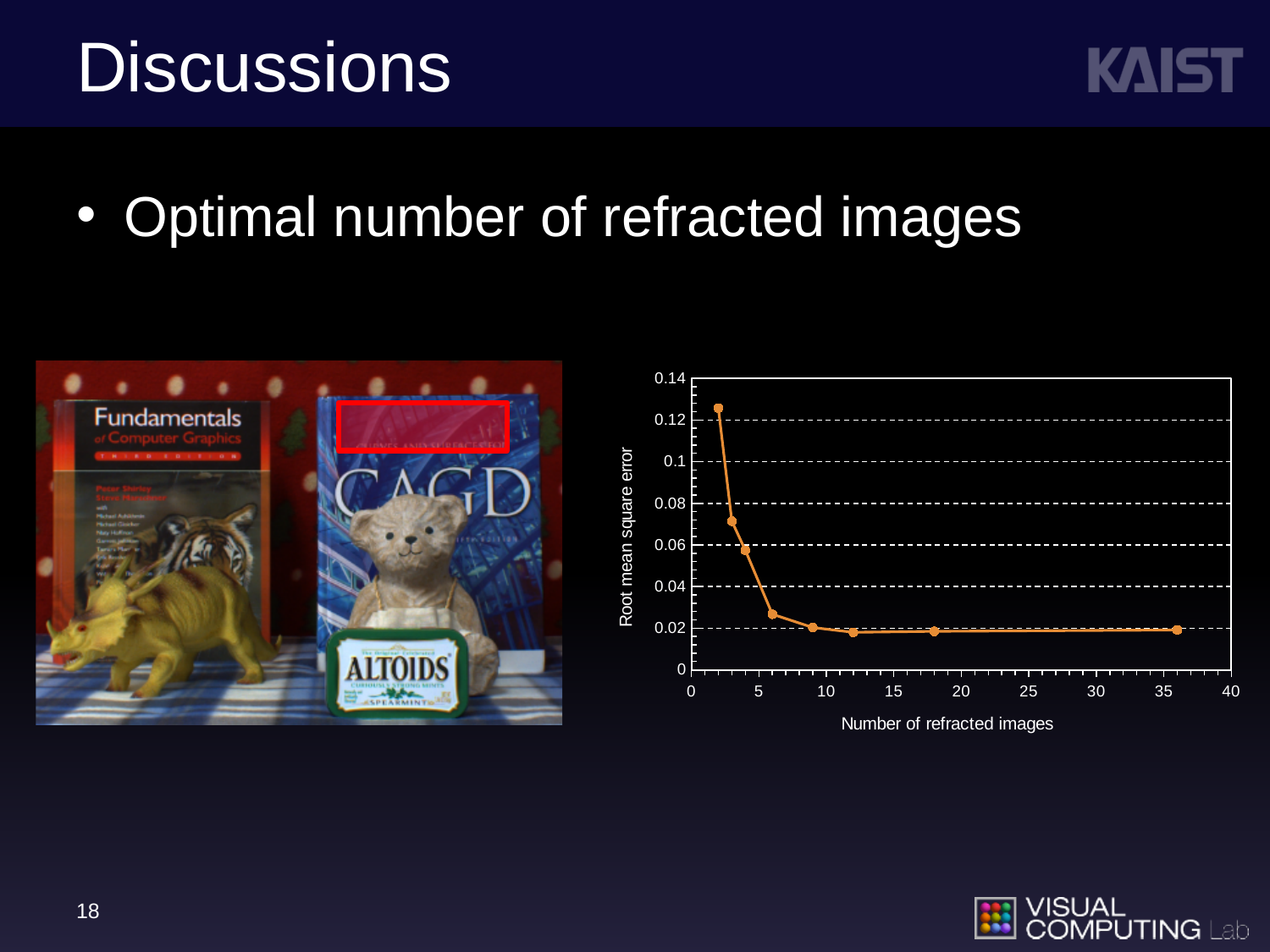
At which number of refracted images is the root mean square error highest? 2 What is the maximum value shown on the x axis of the chart? 40 Is the root mean square error at 2 refracted images greater or less than 0.1? greater What is the label of the x axis of the chart? Number of refracted images What is the label of the y axis of the chart? Root mean square error Does the root mean square error rise or fall as the number of refracted images increases? fall How many data points are plotted on the line? 8 Is the root mean square error at 6 refracted images greater or less than 0.04? less Is the root mean square error at 36 refracted images greater or less than 0.04? less Which has the larger root mean square error: 2 refracted images or 36 refracted images? 2 refracted images What kind of chart is shown on the slide? line chart